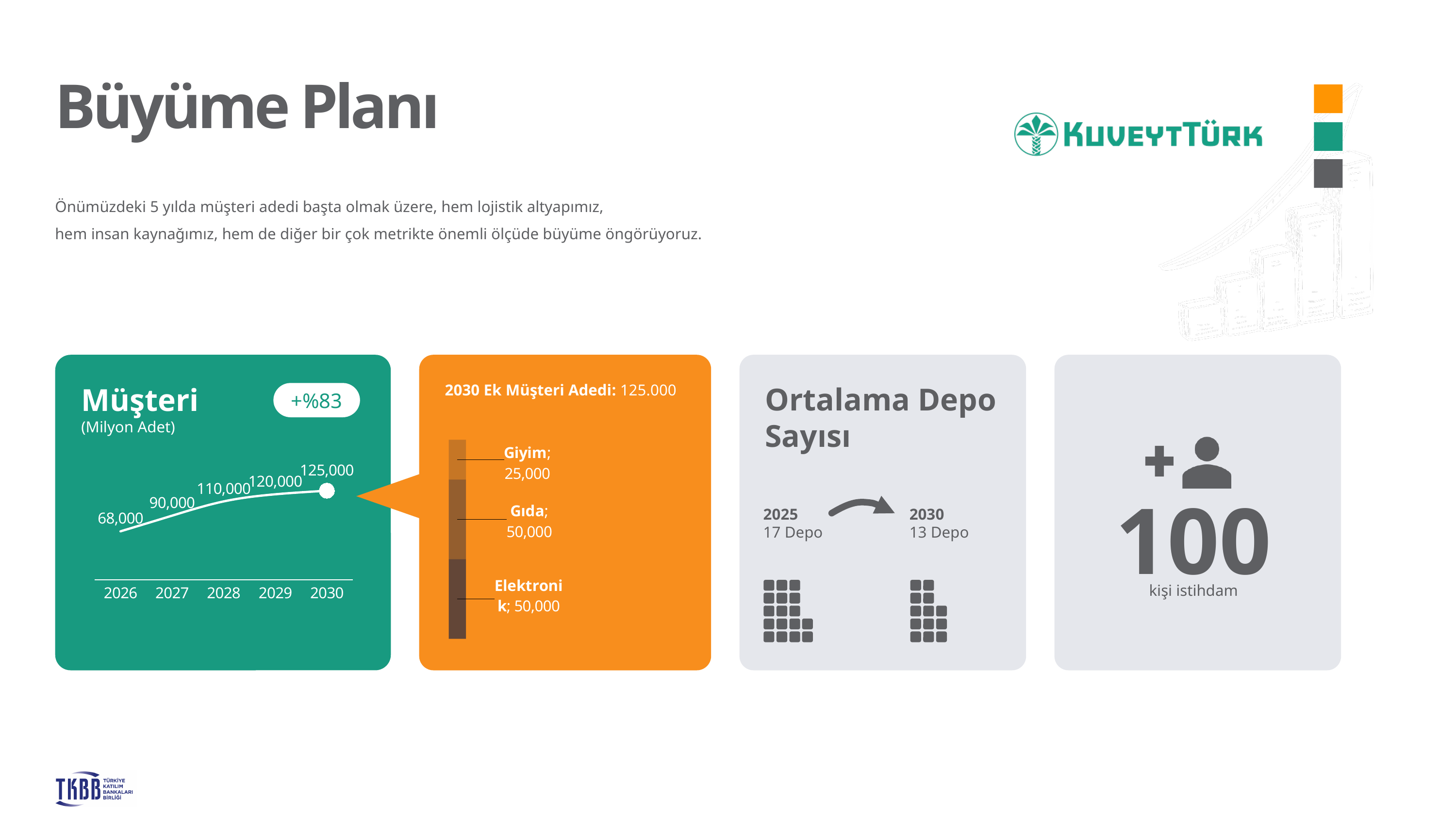
In the Müşteri line chart, what is the value for 2026? 68,000 In the Müşteri line chart, which year has the lowest value? 2026 What kind of chart is shown in the green Müşteri panel? line chart In the stacked bar chart in the orange panel, which segment is larger, Giyim or Gıda? Gıda In the Müşteri line chart, which year has the highest value? 2030 In the Müşteri line chart, what is the value for 2028? 110,000 In the stacked bar chart in the orange panel, what is the total of the stacked bar (Giyim, Gıda and Elektronik)? 125,000 In the Müşteri line chart, what is the difference between the 2030 value and the 2026 value? 57,000 In the Müşteri line chart, what is the value for 2030? 125,000 In the stacked bar chart in the orange panel, what is the value for Giyim? 25,000 In the Müşteri line chart, do the values rise or fall from 2026 to 2030? rise In the Müşteri line chart, how many years are plotted on the x axis? 5